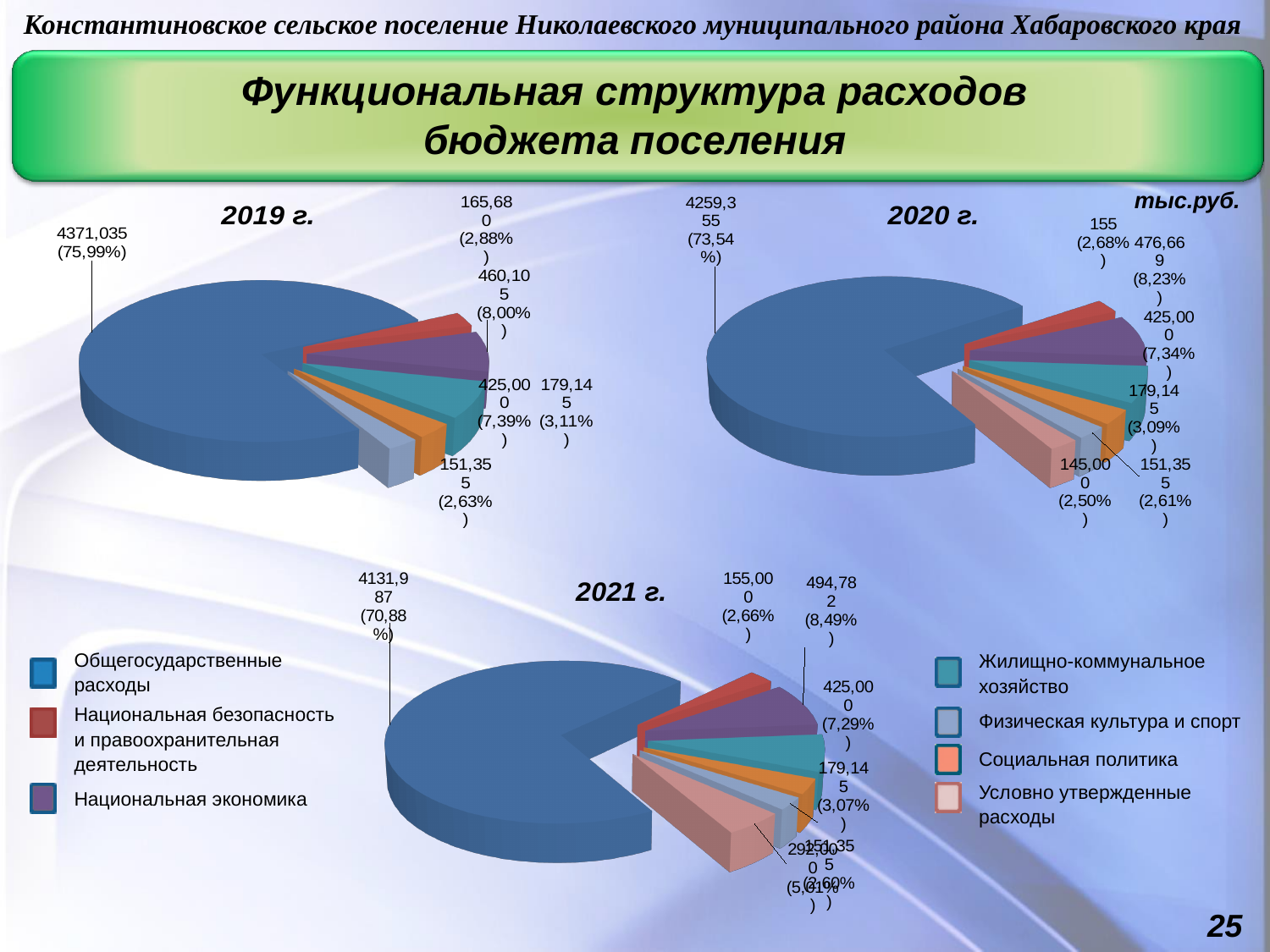
What type of charts are shown on the slide? Pie charts In the 2021 г. chart, what share of the pie is Общегосударственные расходы? 70,88% In the 2020 г. chart, which category has the smallest slice? Условно утвержденные расходы In the 2021 г. chart, what is the value for Жилищно-коммунальное хозяйство? 425,000 In the 2019 г. chart, what share of the pie is Общегосударственные расходы? 75,99% What is the difference between the value for Национальная экономика in 2020 г. and in 2019 г.? 16,564 In the 2020 г. chart, what is the value for Национальная экономика? 476,669 In the 2019 г. chart, which category has the largest slice? Общегосударственные расходы How many slices does the 2019 г. pie chart have? 6 In the 2021 г. chart, which is larger: Национальная экономика or Жилищно-коммунальное хозяйство? Национальная экономика In the 2019 г. chart, what is the value for Общегосударственные расходы? 4371,035 How many categories does the legend list? 7